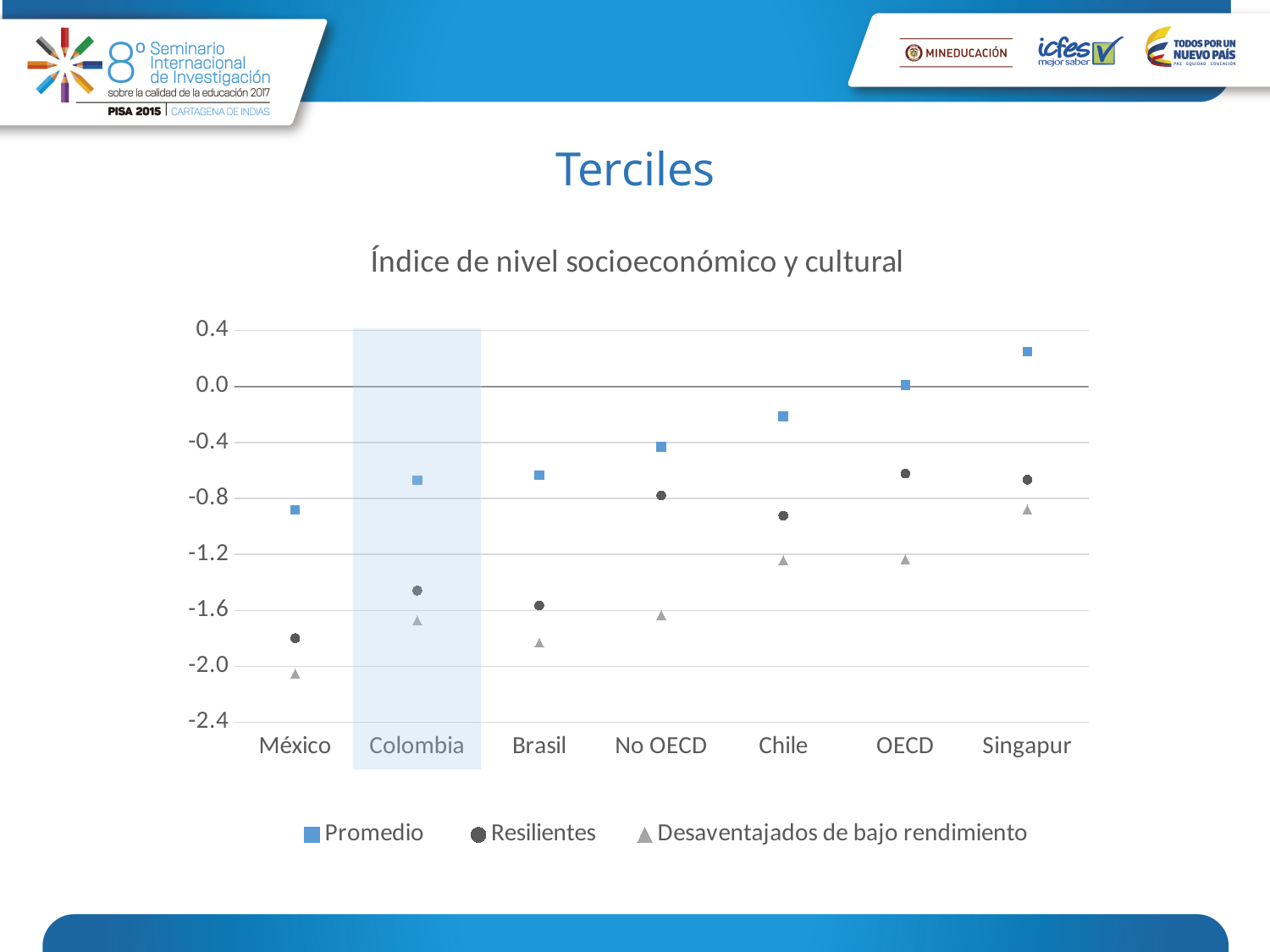
Which has the higher Resilientes value, Colombia or Brasil? Colombia Which category has the highest value for Desaventajados de bajo rendimiento? Singapur What kind of chart is shown on the slide? scatter chart Which category is highlighted with a shaded band in the chart? Colombia Is the Resilientes value for México greater or less than -1.6? less Which category has the lowest Promedio value? México Which category has the highest Promedio value? Singapur Is the Promedio value for México greater or less than -0.8? less Which category has the lowest value for Desaventajados de bajo rendimiento? México How many categories are shown on the x axis? 7 How many series does the legend list? 3 Is the Promedio value for Singapur greater or less than 0.0? greater